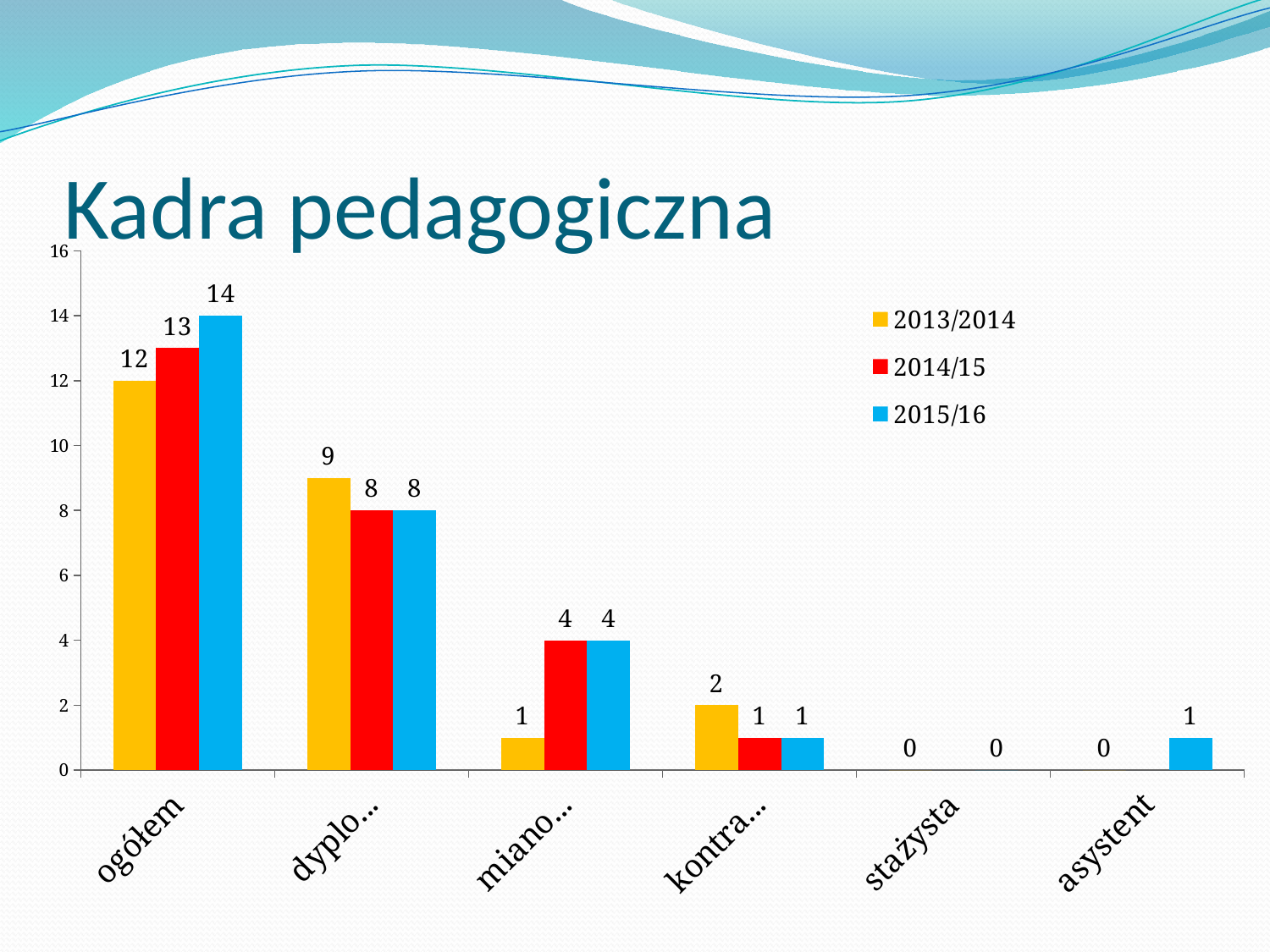
Do the ogółem values rise or fall from 2013/2014 to 2015/16? rise How many series does the legend list? 3 How many categories are shown on the x axis? 6 What kind of chart is shown on the slide? bar chart What is the value for ogółem in 2015/16? 14 What colour represents the 2014/15 series in the legend? red What is the value for ogółem in 2014/15? 13 What is the value for asystent in 2015/16? 1 What is the difference between the ogółem values for 2015/16 and 2013/2014? 2 What is the title of the chart? Kadra pedagogiczna Which category has the highest value for the 2015/16 series? ogółem What is the value for ogółem in 2013/2014? 12